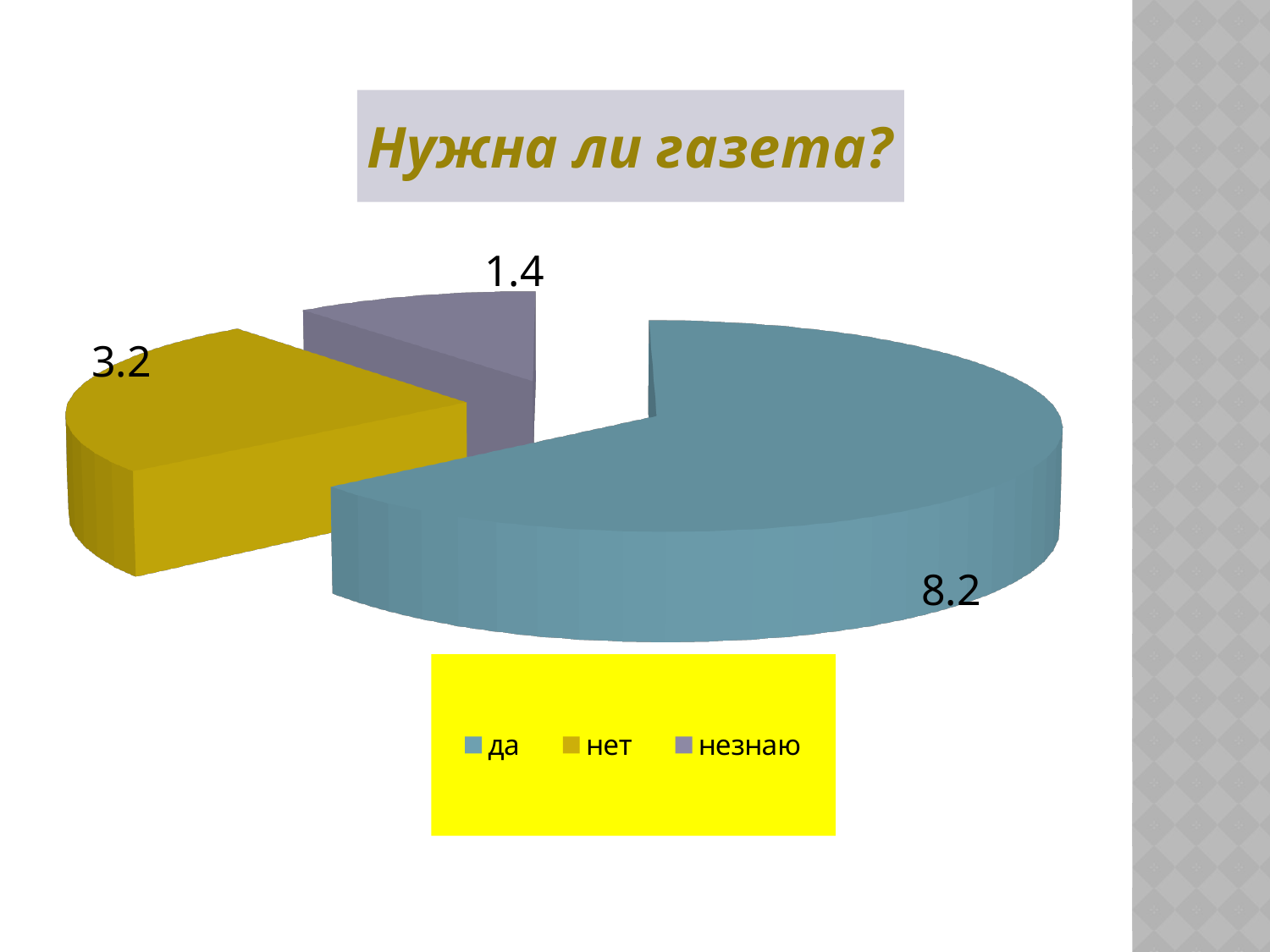
What is the title of the chart? Нужна ли газета? What is the difference between the values for "да" and "нет"? 5.0 What share of the pie does the "нет" slice represent? 25% What is the value for the "да" slice? 8.2 Which category has the smallest slice? незнаю What type of chart is shown on the slide? pie chart What is the value for the "нет" slice? 3.2 How many slices does the pie chart have? 3 What is the value for the "незнаю" slice? 1.4 What is the difference between the values for "нет" and "незнаю"? 1.8 Which category has the largest slice? да Which is larger, the value for "нет" or the value for "незнаю"? нет